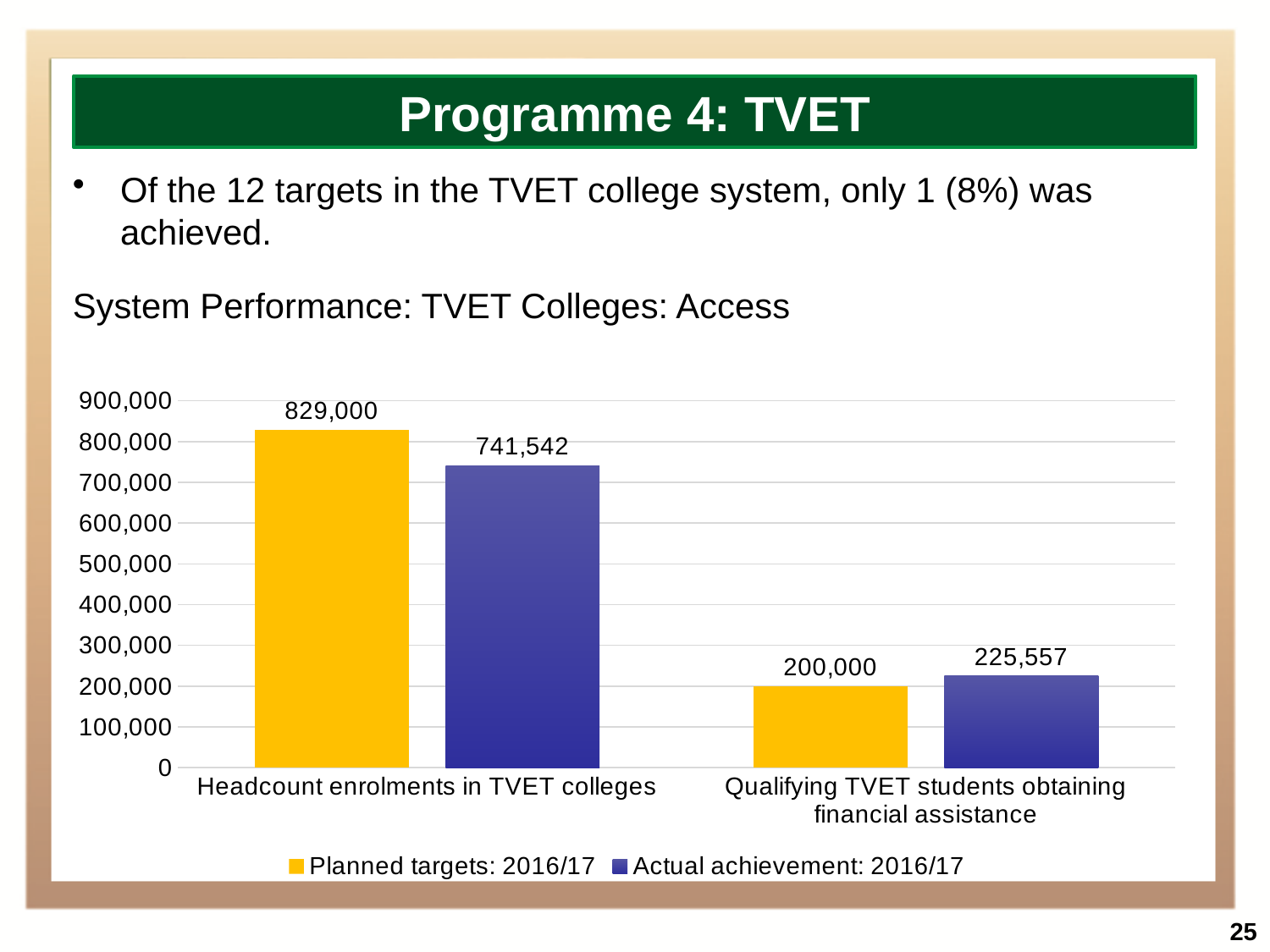
How many series does the chart legend list? 2 What was the actual achievement in 2016/17 for Headcount enrolments in TVET colleges? 741,542 What was the actual achievement in 2016/17 for Qualifying TVET students obtaining financial assistance? 225,557 By how much did the actual achievement exceed the planned target for Qualifying TVET students obtaining financial assistance? 25,557 What is the planned target for 2016/17 for Qualifying TVET students obtaining financial assistance? 200,000 For Qualifying TVET students obtaining financial assistance, which is larger: the planned target or the actual achievement? Actual achievement: 2016/17 How many categories are shown on the x axis of the chart? 2 Which category has the highest planned target for 2016/17? Headcount enrolments in TVET colleges What kind of chart is shown on the slide? Bar chart What is the planned target for 2016/17 for Headcount enrolments in TVET colleges? 829,000 By how much did the actual achievement fall short of the planned target for Headcount enrolments in TVET colleges? 87,458 Which category has the lowest actual achievement for 2016/17? Qualifying TVET students obtaining financial assistance